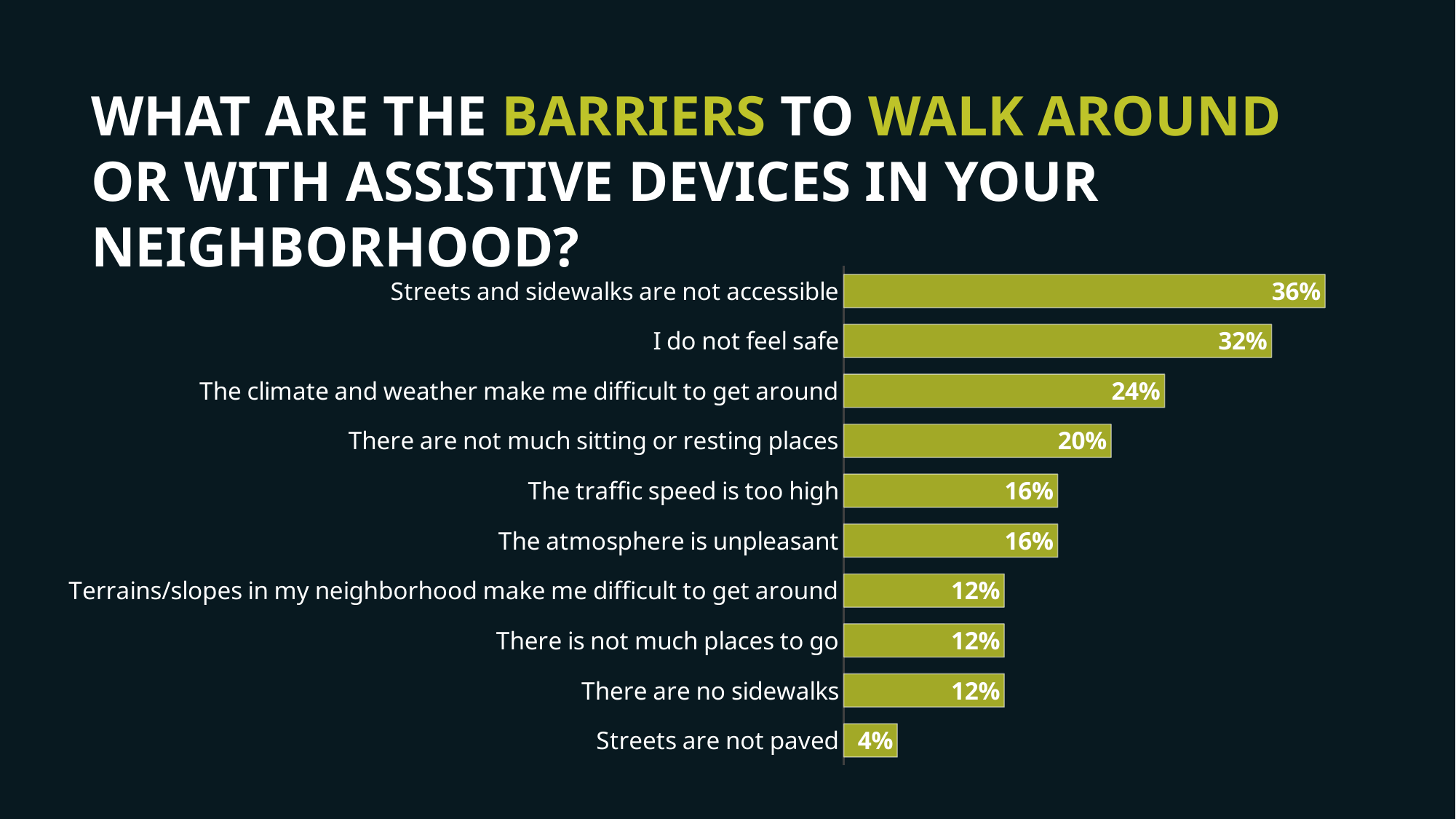
What percentage is shown for "Streets are not paved"? 4% What is the value for "I do not feel safe"? 32% Which barrier has the highest percentage? Streets and sidewalks are not accessible What is the value for "There are not much sitting or resting places"? 20% How many barriers are listed in the chart? 10 What percentage is shown for "The climate and weather make me difficult to get around"? 24% How many barriers share the value 12%? 3 Which barrier has the lowest percentage? Streets are not paved What type of chart is shown on the slide? Bar chart What percentage of respondents said streets and sidewalks are not accessible? 36% Which is larger: "The traffic speed is too high" or "There are no sidewalks"? The traffic speed is too high What is the difference between "Streets and sidewalks are not accessible" and "I do not feel safe"? 4%